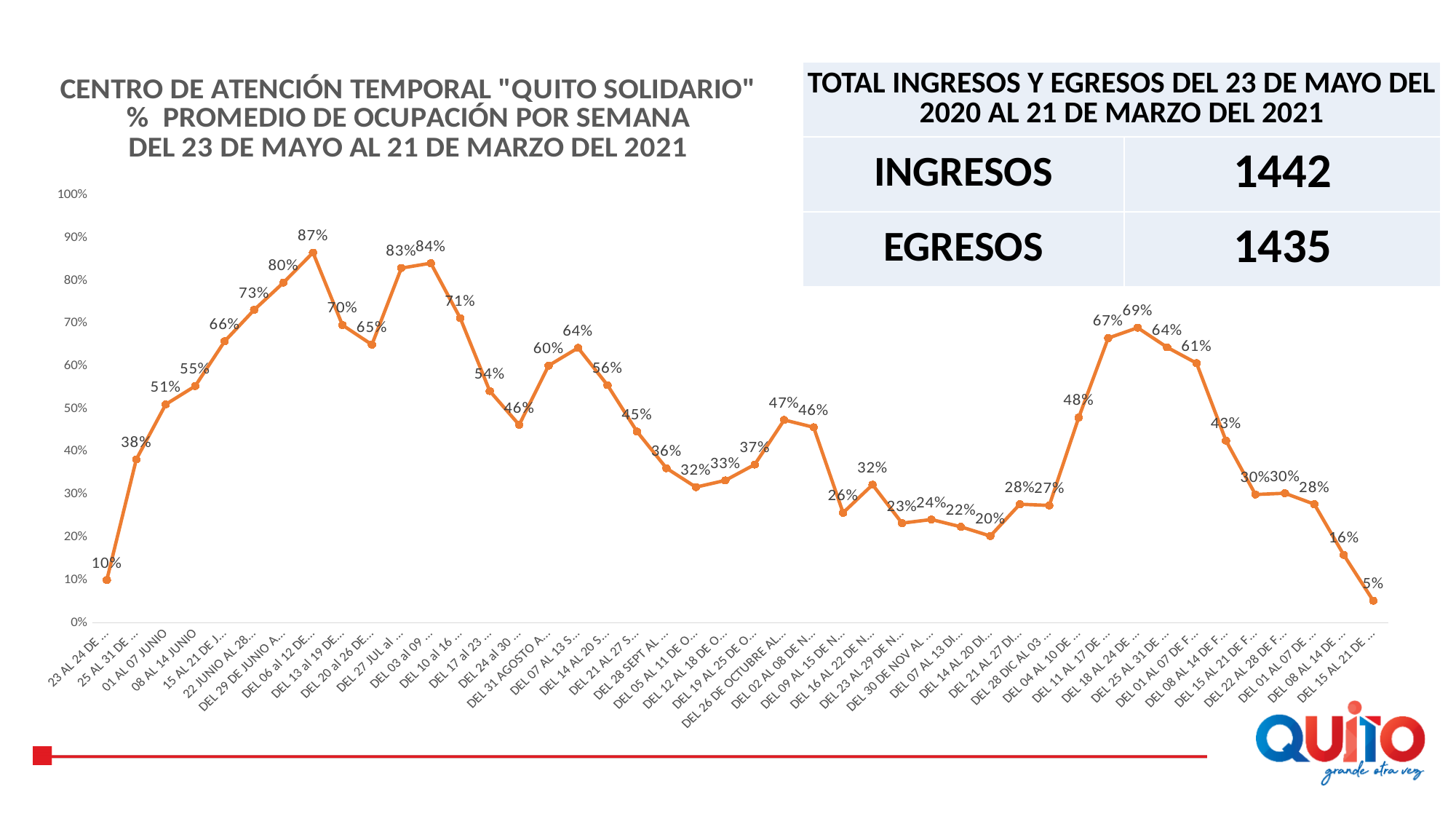
What is the value of the first point on the line (the leftmost week)? 10% What is the value of the last point on the line (the rightmost week)? 5% What is the value for the week 01 AL 07 JUNIO? 51% Which week has the larger value, 01 AL 07 JUNIO or 08 AL 14 JUNIO? 08 AL 14 JUNIO What is the lowest weekly occupancy value shown on the chart? 5% Do the values rise or fall over the first eight weeks of the chart? rise What kind of chart is shown on the slide? line chart What is the value for the week 08 AL 14 JUNIO? 55% What colour is the line on the chart? orange What is the highest weekly occupancy value shown on the chart? 87% How many weekly data points are plotted on the line? 44 What is the difference between the values for 08 AL 14 JUNIO and 01 AL 07 JUNIO? 4%